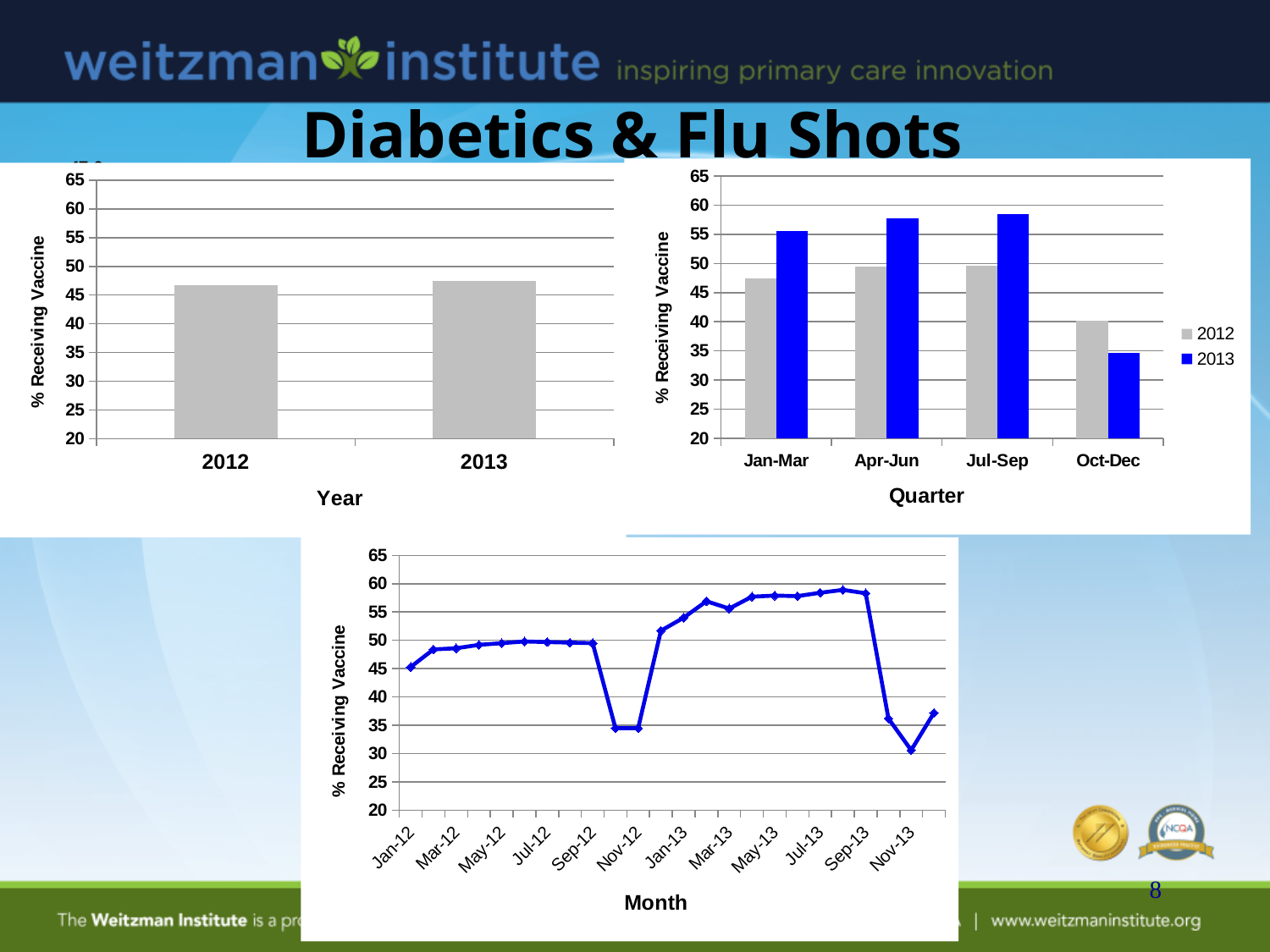
What kind of chart is the bottom chart (by Month)? line chart How many quarters are shown on the x axis of the top-right chart (by Quarter)? 4 In the bottom chart (by Month), do the values rise or fall from Jan-12 to Jul-12? rise In the top-right chart (by Quarter), is the 2013 value for Jan-Mar greater or less than 50? greater How many series does the legend of the top-right chart (by Quarter) list? 2 In the bottom chart (by Month), is the value for Nov-12 greater or less than 40? less In the top-left chart (by Year), is the value for 2012 greater or less than 50? less In the top-right chart (by Quarter), which quarter has the highest 2013 value? Jul-Sep What kind of chart is the top-left chart (by Year)? bar chart In the top-right chart (by Quarter), which is larger for Oct-Dec: the 2012 value or the 2013 value? 2012 In the top-right chart (by Quarter), which quarter has the lowest 2012 value? Oct-Dec In the bottom chart (by Month), which month has the lowest value? Nov-13